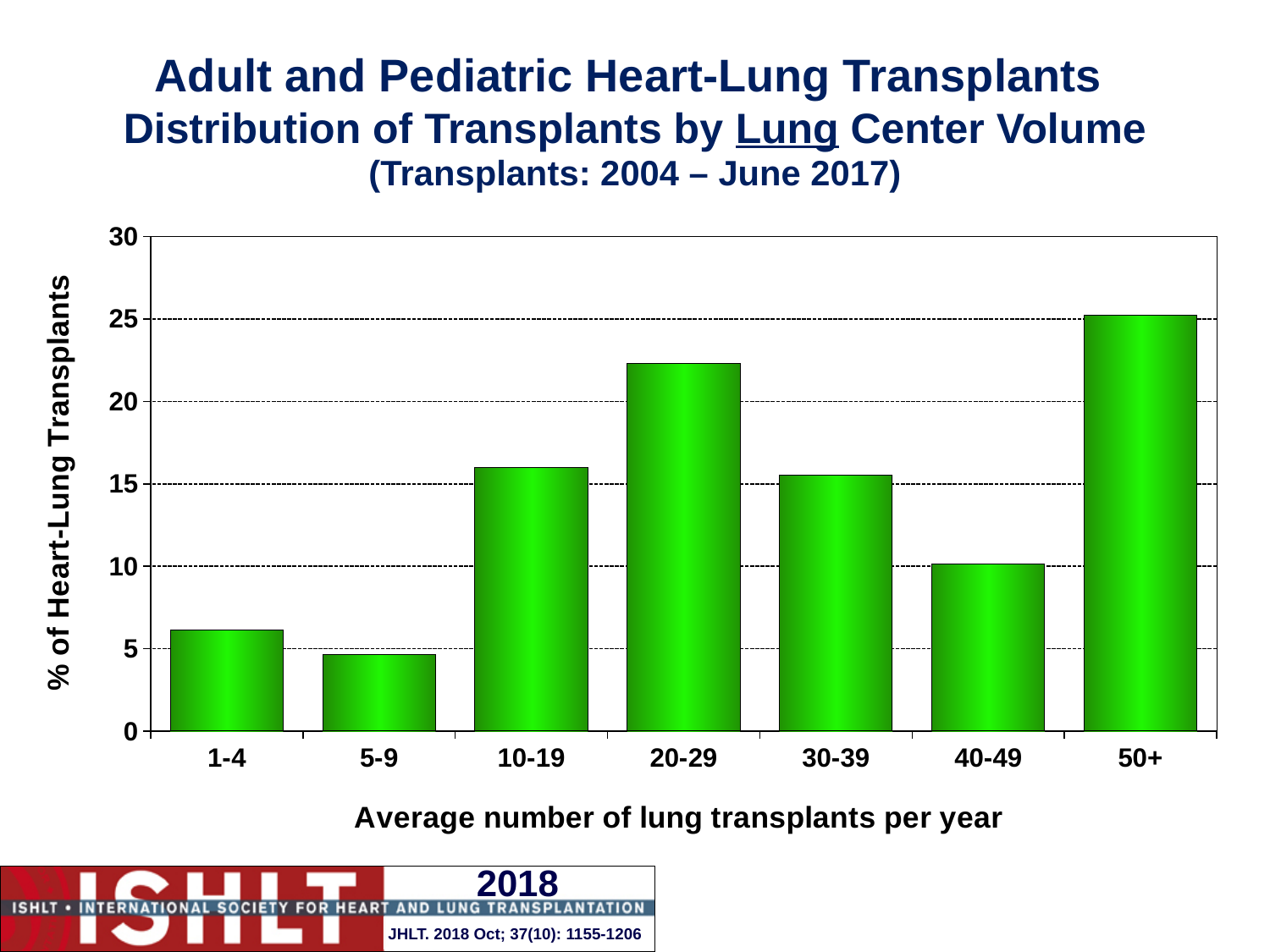
Which lung center volume category has the lowest percentage of heart-lung transplants? 5-9 What kind of chart is shown on the slide? bar chart Is the value for the 40-49 category greater or less than 15? less Is the value for the 5-9 category greater or less than 5? less How many lung center volume categories are shown on the x axis? 7 Which has a higher percentage of heart-lung transplants, the 20-29 category or the 30-39 category? 20-29 Is the value for the 1-4 category greater or less than 5? greater What is the label of the x axis? Average number of lung transplants per year Which has a higher percentage of heart-lung transplants, the 1-4 category or the 5-9 category? 1-4 Which lung center volume category has the highest percentage of heart-lung transplants? 50+